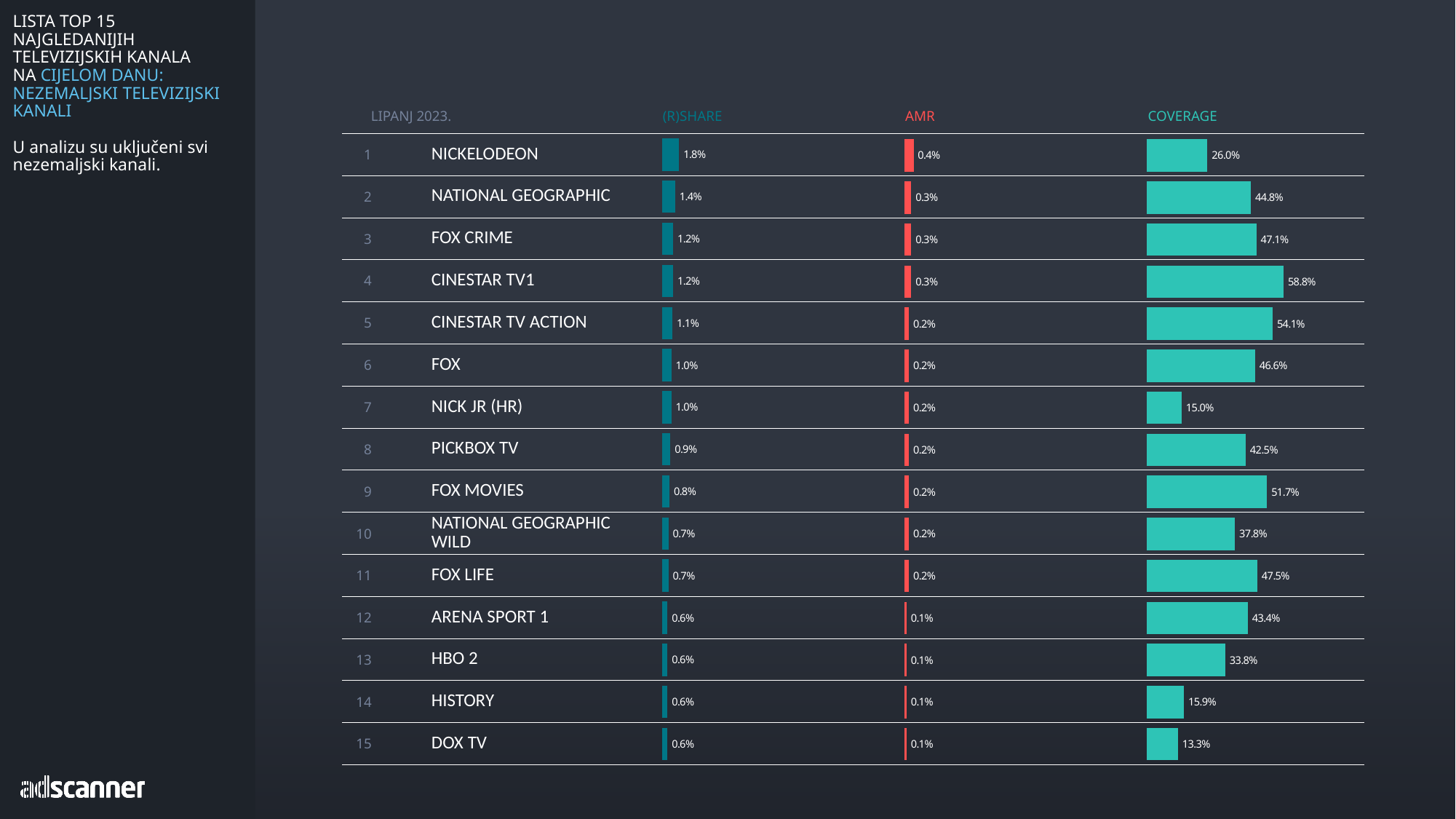
In the COVERAGE chart, what is the value for CINESTAR TV1? 58.8% In the COVERAGE chart, which is larger, FOX MOVIES or PICKBOX TV? FOX MOVIES How many channels are listed in the chart? 15 In the (R)SHARE chart, what is the value for NICKELODEON? 1.8% In the COVERAGE chart, which channel has the highest value? CINESTAR TV1 In the (R)SHARE chart, which channel has the highest value? NICKELODEON In the (R)SHARE chart, what is the difference between NICKELODEON and NATIONAL GEOGRAPHIC? 0.4% In the AMR chart, what is the value for FOX CRIME? 0.3% Do the (R)SHARE values rise or fall going down the list from rank 1 to rank 15? Fall What kind of chart is used to show the (R)SHARE, AMR and COVERAGE values? Bar chart In the COVERAGE chart, what is the difference between CINESTAR TV1 and NICKELODEON? 32.8% In the COVERAGE chart, which channel has the lowest value? DOX TV